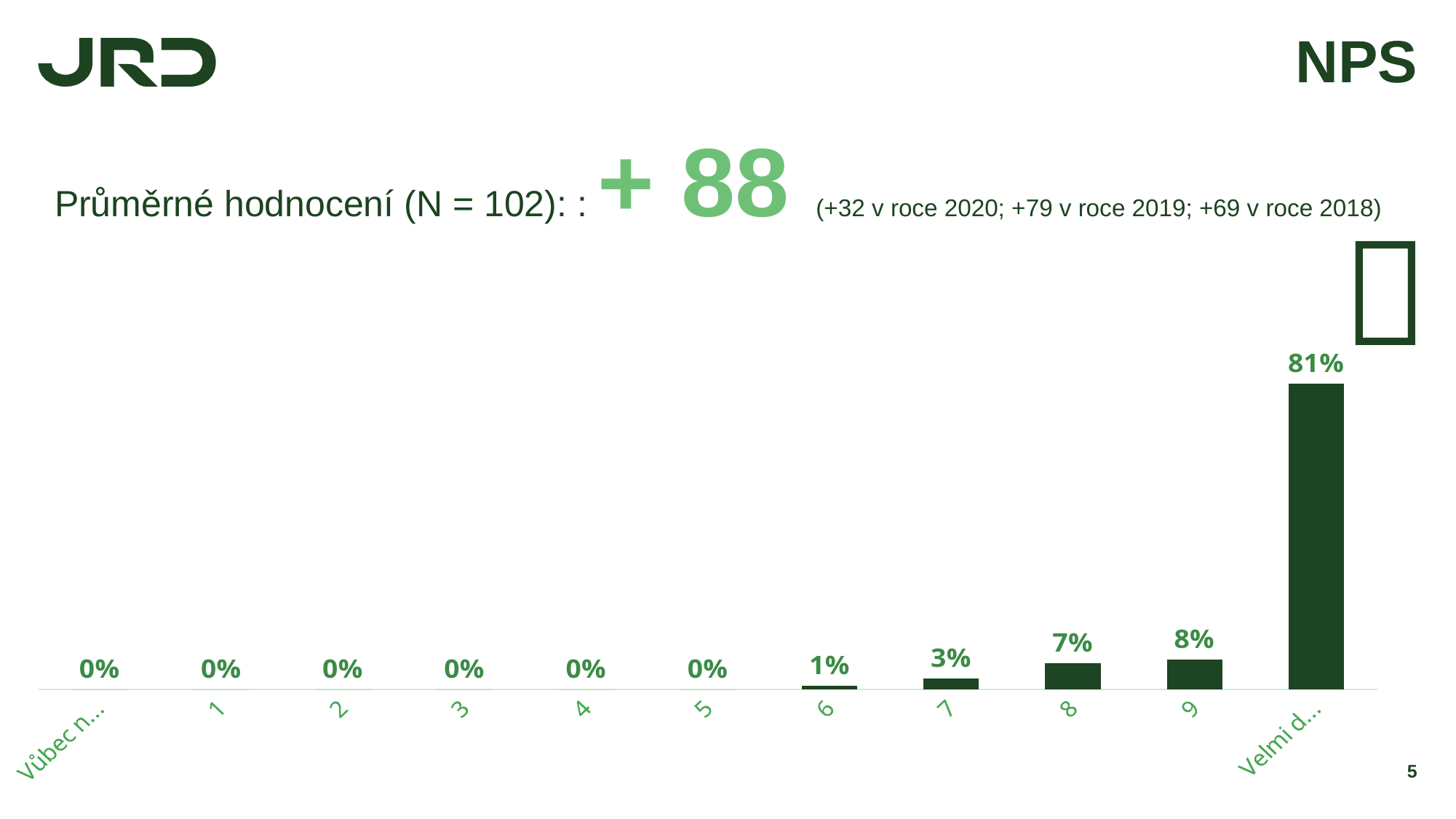
Do the values generally rise or fall moving from left to right along the x axis? rise What is the value for category 5? 0% What is the value for category 9? 8% How many categories are shown on the x axis of the chart? 11 What is the average NPS rating stated on the slide (N = 102)? + 88 What is the value for category 8? 7% What is the value for category 6? 1% What kind of chart is shown on the slide? bar chart What is the value shown on the rightmost bar of the chart? 81% Which is larger, the value for category 7 or the value for category 8? category 8 What is the difference between the values for category 9 and category 8? 1% What is the value for category 7? 3%